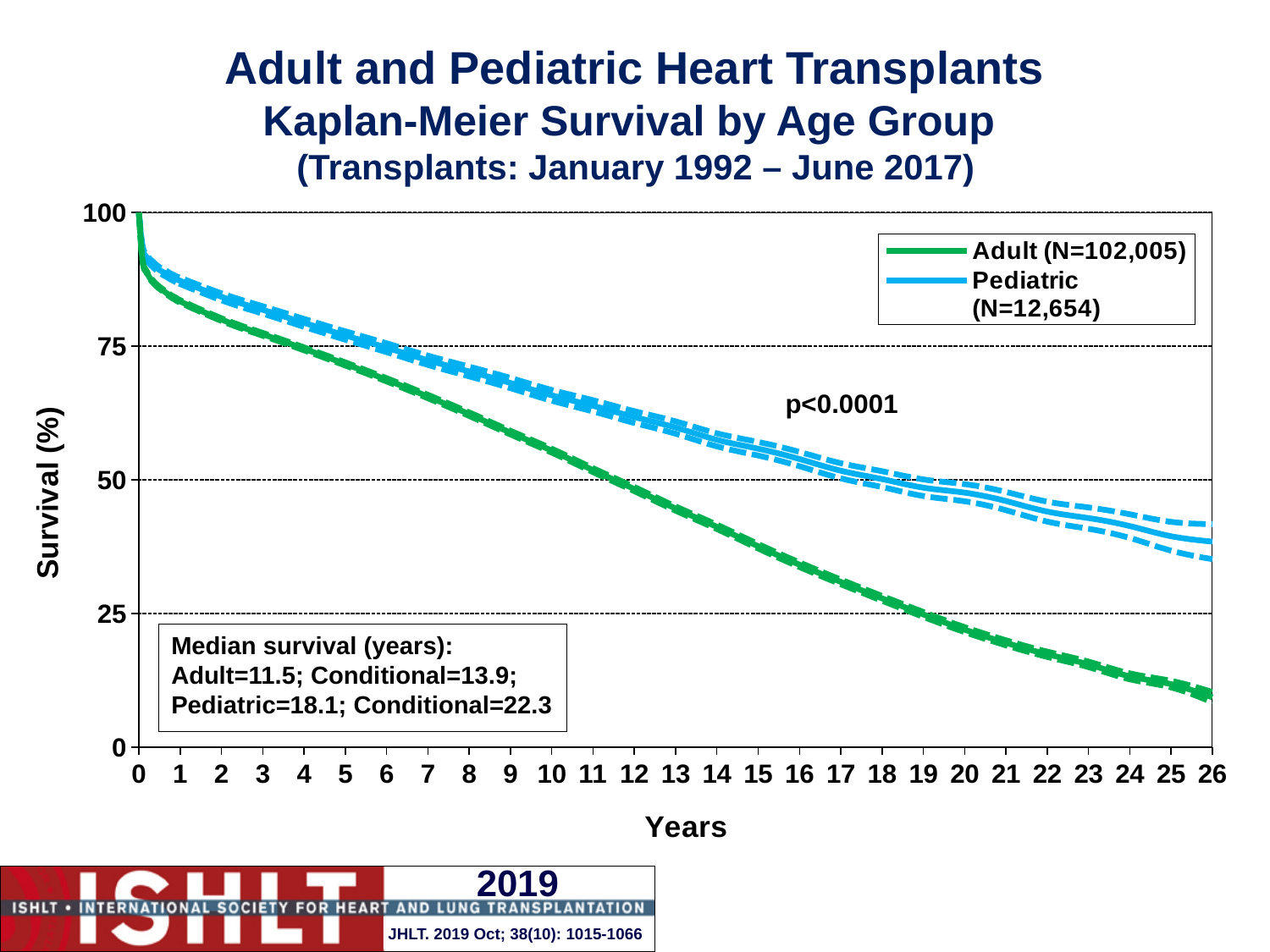
How many series does the legend list? 2 What kind of chart is shown on the slide? line chart Is the pediatric survival at 10 years greater or less than 50%? greater According to the legend, how many adult heart transplant recipients (N) are included? 102,005 At 20 years after transplant, which group has the higher survival, Adult or Pediatric? Pediatric What is the difference in median survival (years) between pediatric and adult recipients? 6.6 What is the conditional median survival in years for pediatric recipients? 22.3 What is the median survival in years for pediatric heart transplant recipients? 18.1 What is the median survival in years for adult heart transplant recipients? 11.5 Is the adult survival at 26 years greater or less than 25%? less What p-value is shown on the chart for the comparison between the two age groups? p<0.0001 Do the survival curves rise or fall as years since transplant increase? fall